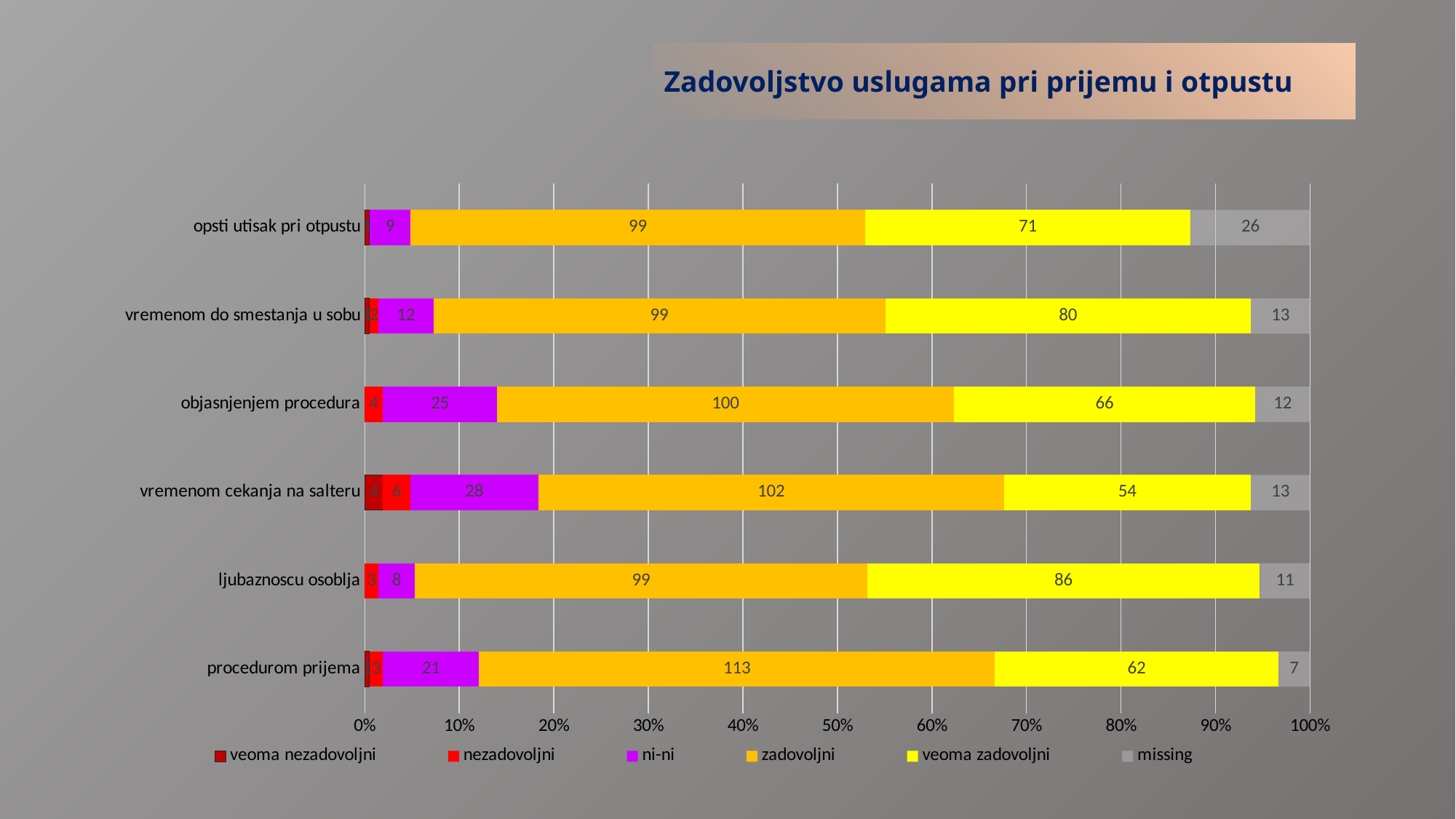
How many categories are shown on the vertical axis of the chart? 6 Which category has the highest 'veoma zadovoljni' value? ljubaznoscu osoblja What is the 'missing' value for 'opsti utisak pri otpustu'? 26 What kind of chart is shown on the slide? Stacked bar chart What is the 'zadovoljni' value for 'procedurom prijema'? 113 How many series does the legend list? 6 What is the difference between the 'veoma zadovoljni' values for 'vremenom do smestanja u sobu' and 'opsti utisak pri otpustu'? 9 Which category has the lowest 'veoma zadovoljni' value? vremenom cekanja na salteru What is the 'ni-ni' value for 'vremenom do smestanja u sobu'? 12 Which has the larger 'ni-ni' value: 'vremenom cekanja na salteru' or 'objasnjenjem procedura'? vremenom cekanja na salteru Which category has the highest 'missing' value? opsti utisak pri otpustu What is the 'nezadovoljni' value for 'vremenom cekanja na salteru'? 6